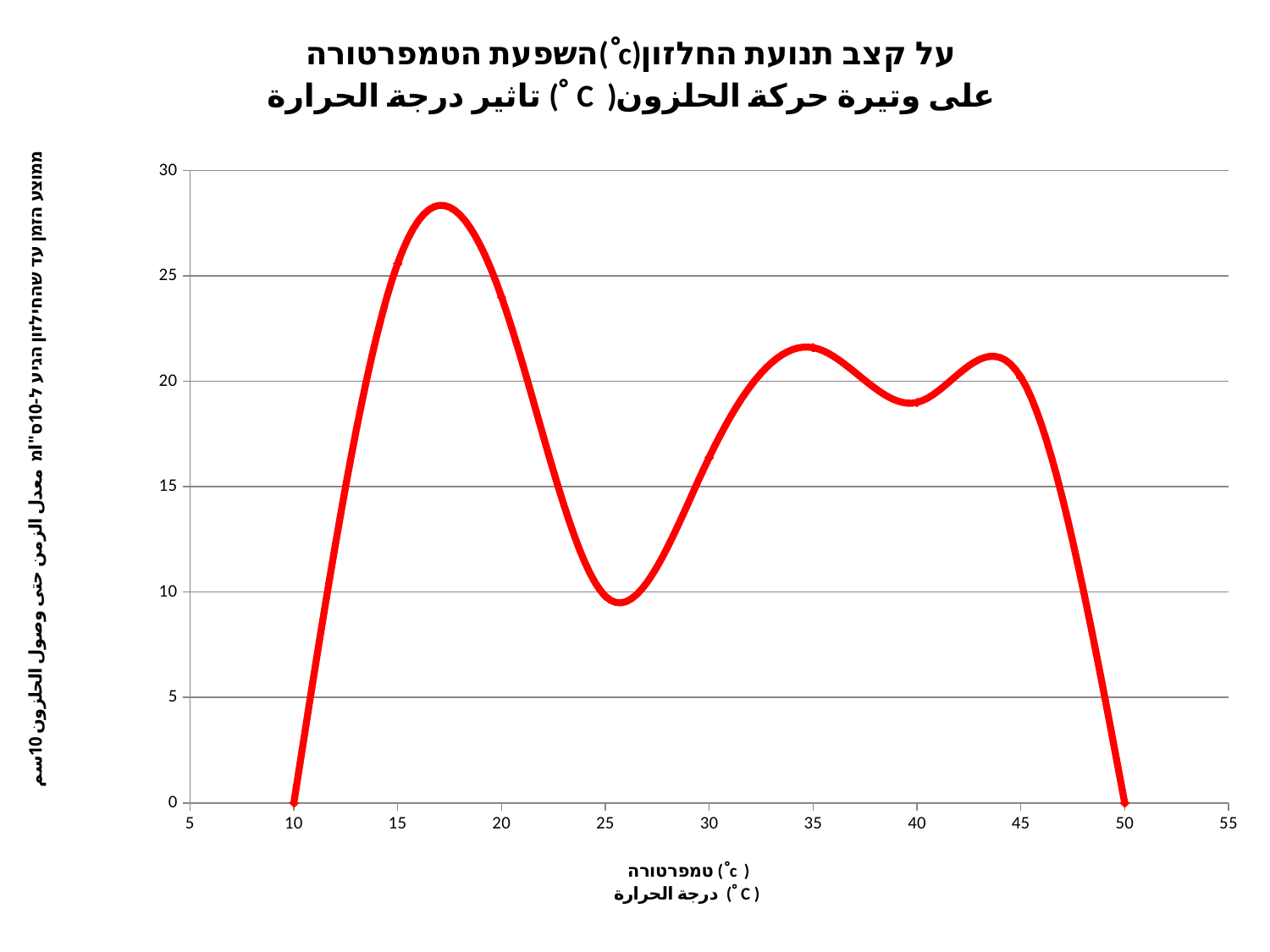
What is the plotted value at a temperature of 10 on the x axis? 0 Does the curve rise or fall as the temperature goes from 20 to 25? fall What is the plotted value at a temperature of 50 on the x axis? 0 Which is higher: the peak of the curve between 15 and 20 on the x axis, or the peak between 30 and 35? the peak between 15 and 20 What colour is the plotted line? red Is the value at a temperature of 15 greater or less than 20? greater Is the value at a temperature of 25 greater or less than 15? less What kind of chart is shown on the slide? line chart Does the curve rise or fall as the temperature goes from 10 to 15? rise Is the value at a temperature of 40 greater or less than 20? less Does the curve rise or fall as the temperature goes from 45 to 50? fall